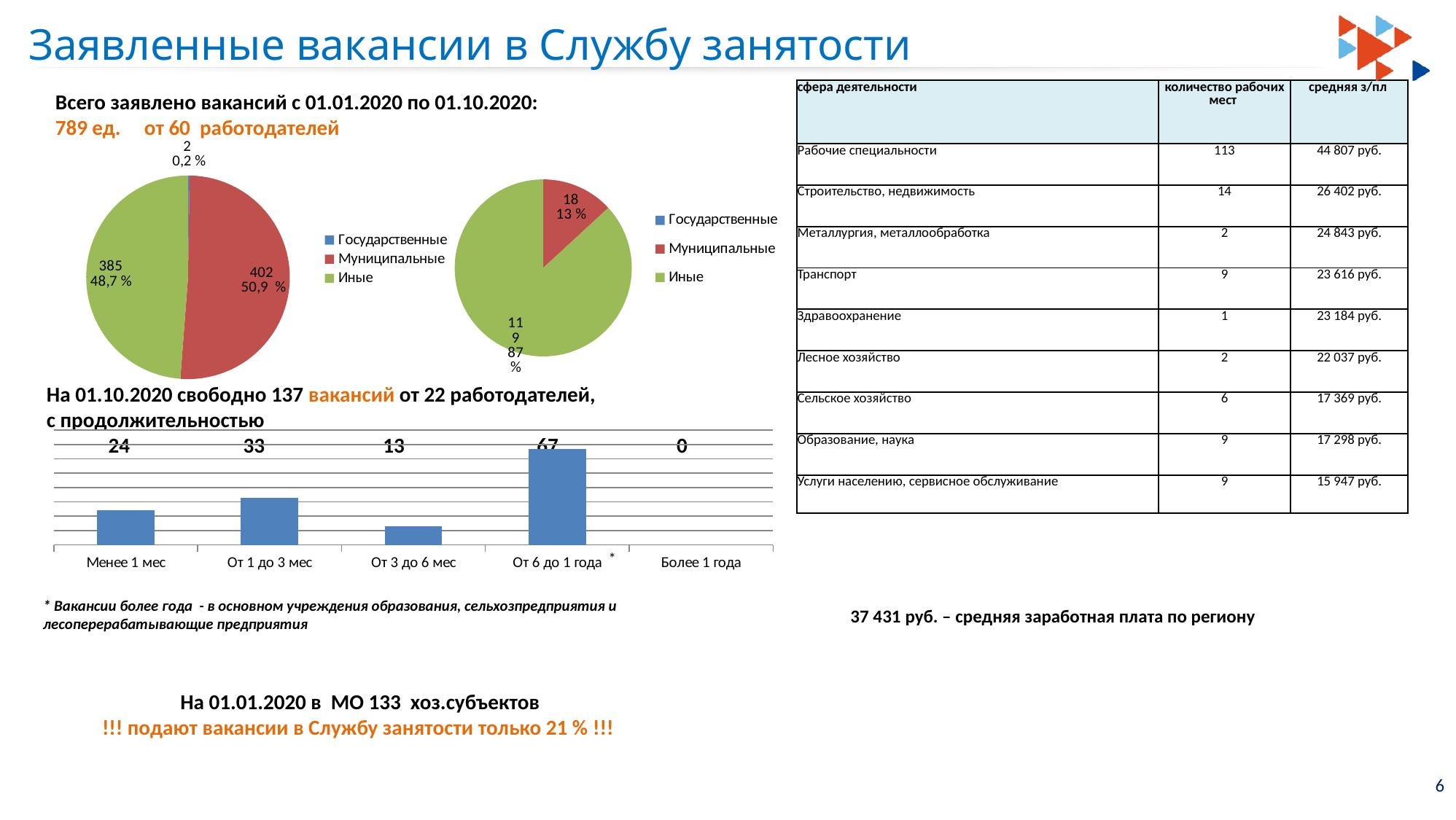
How many entries does the legend of the right pie chart list? 3 In the bar chart at the bottom left, what is the value for От 6 до 1 года? 67 In the left pie chart, what percentage share is shown for the Иные slice? 48,7 % In the right pie chart, what percentage share is shown for the Иные slice? 87 % What type of chart is the chart at the bottom left of the slide? bar chart In the bar chart at the bottom left, what is the difference between От 1 до 3 мес and Менее 1 мес? 9 In the left pie chart, what is the difference between the Муниципальные value and the Иные value? 17 In the left pie chart, which category has the smallest slice? Государственные In the left pie chart, what value is shown for the Муниципальные slice? 402 How many categories are shown on the x axis of the bar chart at the bottom left? 5 In the bar chart at the bottom left, which category has the highest value? От 6 до 1 года In the right pie chart, what value is shown for the Муниципальные slice? 18